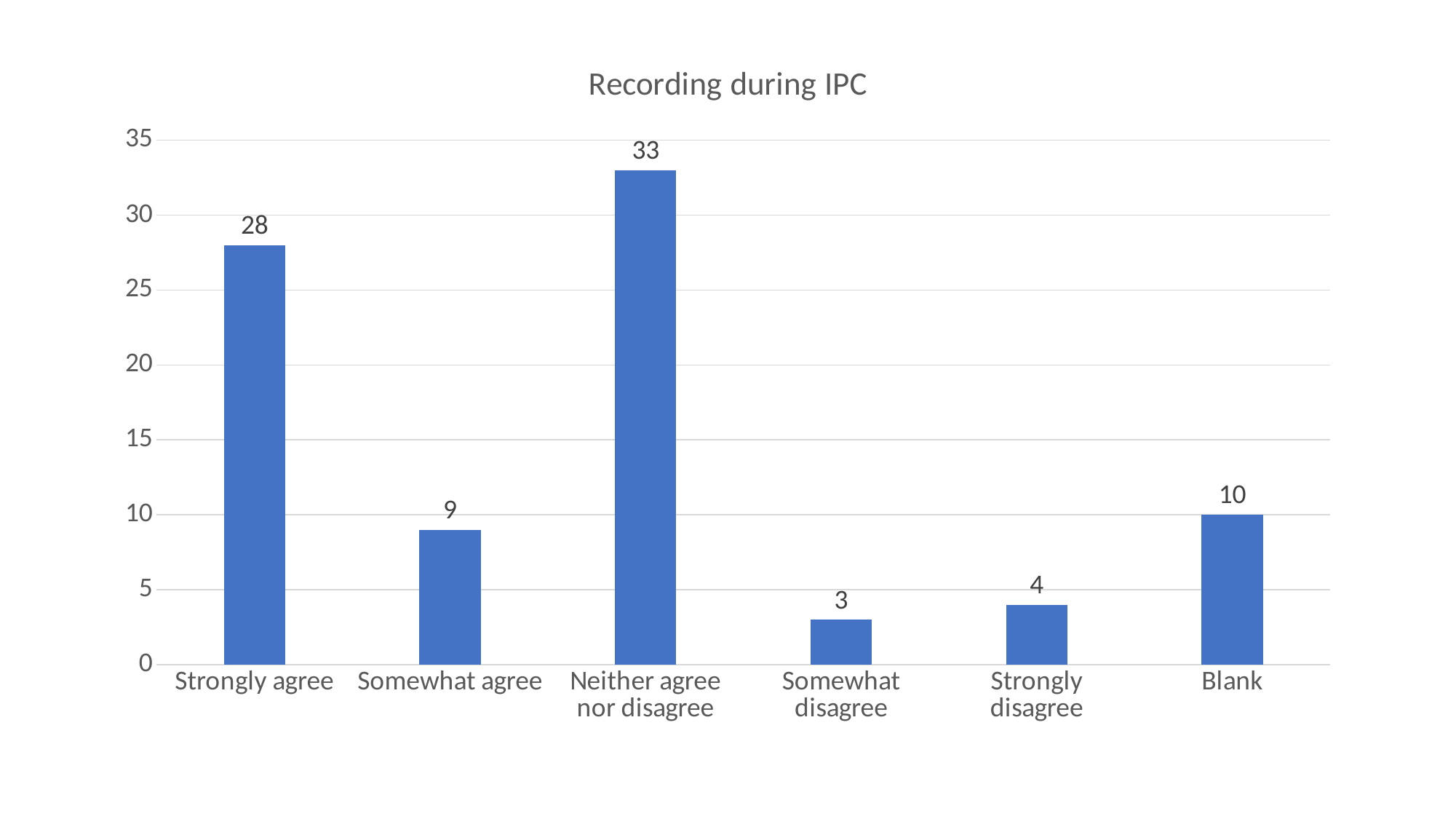
What kind of chart is this? Bar chart Which category has the lowest value? Somewhat disagree How many categories are shown on the x axis? 6 What is the value for Somewhat disagree? 3 What is the value for Strongly agree? 28 What is the value for Neither agree nor disagree? 33 Which is larger, the value for Somewhat agree or the value for Blank? Blank Which category has the highest value? Neither agree nor disagree What is the title of the chart? Recording during IPC What is the difference between the values for Neither agree nor disagree and Strongly agree? 5 Is the value for Strongly agree greater or less than 25? greater What is the value for Blank? 10